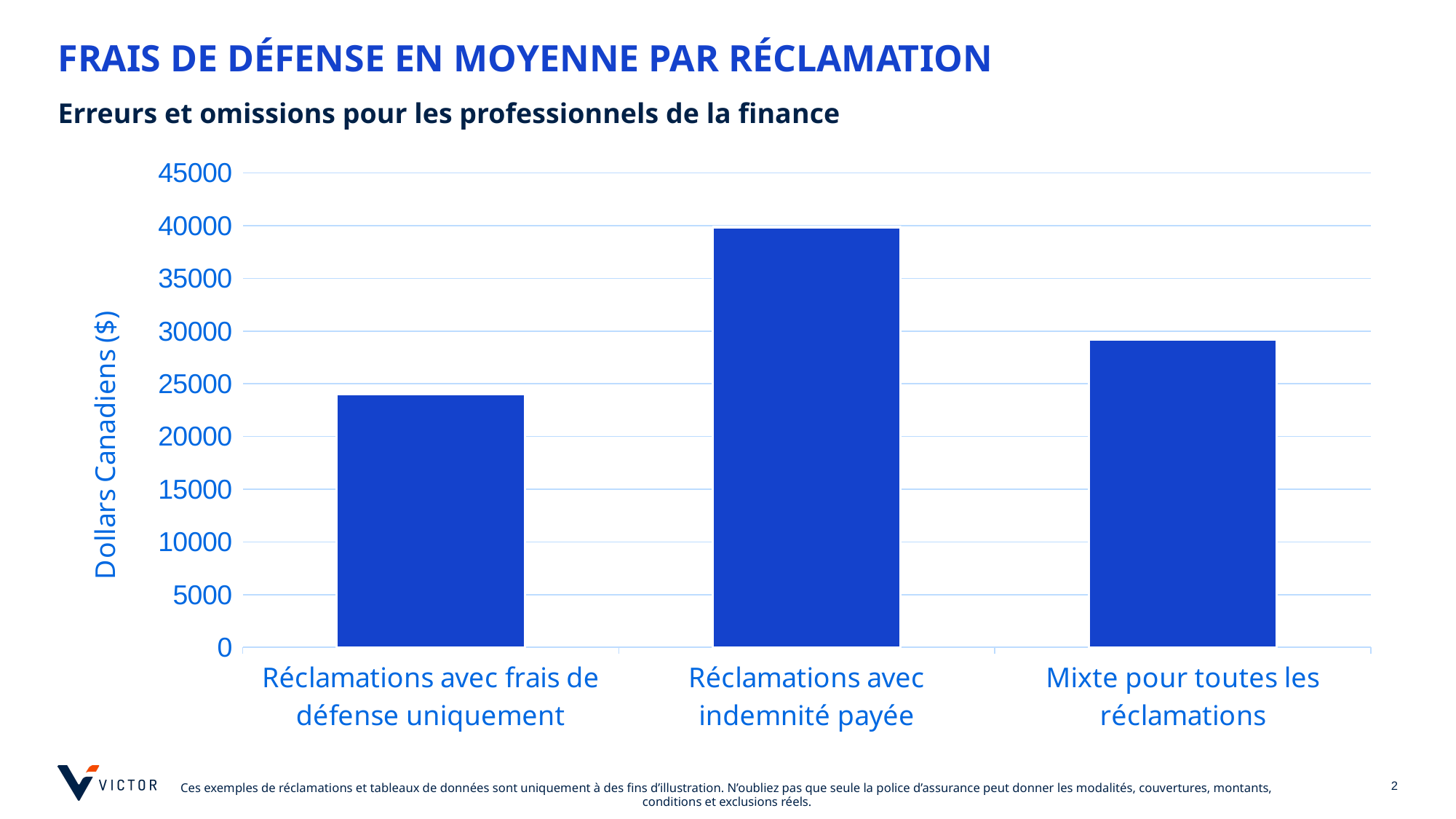
Which is larger: the value for 'Mixte pour toutes les réclamations' or the value for 'Réclamations avec frais de défense uniquement'? Mixte pour toutes les réclamations What is the title of the slide containing the chart? FRAIS DE DÉFENSE EN MOYENNE PAR RÉCLAMATION Which is larger: the value for 'Réclamations avec indemnité payée' or the value for 'Mixte pour toutes les réclamations'? Réclamations avec indemnité payée Which category has the highest average defence cost? Réclamations avec indemnité payée What kind of chart is shown on the slide? bar chart How many categories are plotted in the chart? 3 Which category has the lowest average defence cost? Réclamations avec frais de défense uniquement What is the label of the vertical axis? Dollars Canadiens ($) Is the value for 'Réclamations avec frais de défense uniquement' greater or less than 25000? less Is the value for 'Mixte pour toutes les réclamations' greater or less than 25000? greater Is the value for 'Réclamations avec indemnité payée' greater or less than 35000? greater